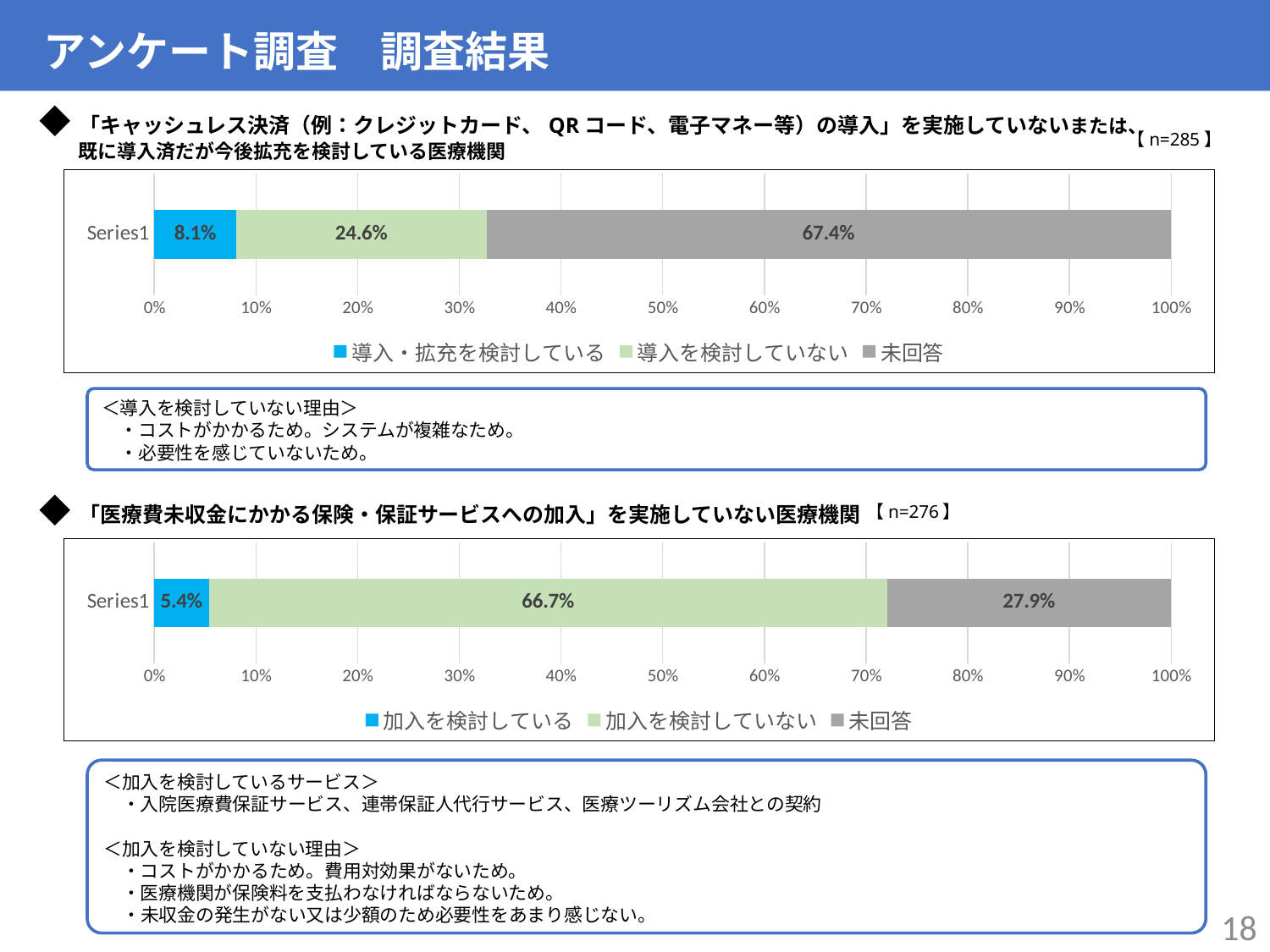
In the top chart (cashless payment), what is the value for 導入・拡充を検討している? 8.1% In the bottom chart (insurance/guarantee service), what is the value for 加入を検討している? 5.4% In the bottom chart (insurance/guarantee service), which legend category has the smallest share? 加入を検討している In the bottom chart (insurance/guarantee service), what is the difference between 未回答 and 加入を検討している? 22.5% In the top chart (cashless payment), which legend category has the largest share? 未回答 In the top chart (cashless payment), what colour is the 未回答 segment? Gray In the top chart (cashless payment), how many series does the legend list? 3 In the bottom chart (insurance/guarantee service), which is larger: 加入を検討していない or 未回答? 加入を検討していない In the top chart (cashless payment), what is the value for 未回答? 67.4% What type of chart is the top chart (cashless payment)? Stacked bar chart In the bottom chart (insurance/guarantee service), what is the value for 加入を検討していない? 66.7% In the top chart (cashless payment), what is the difference between 未回答 and 導入を検討していない? 42.8%